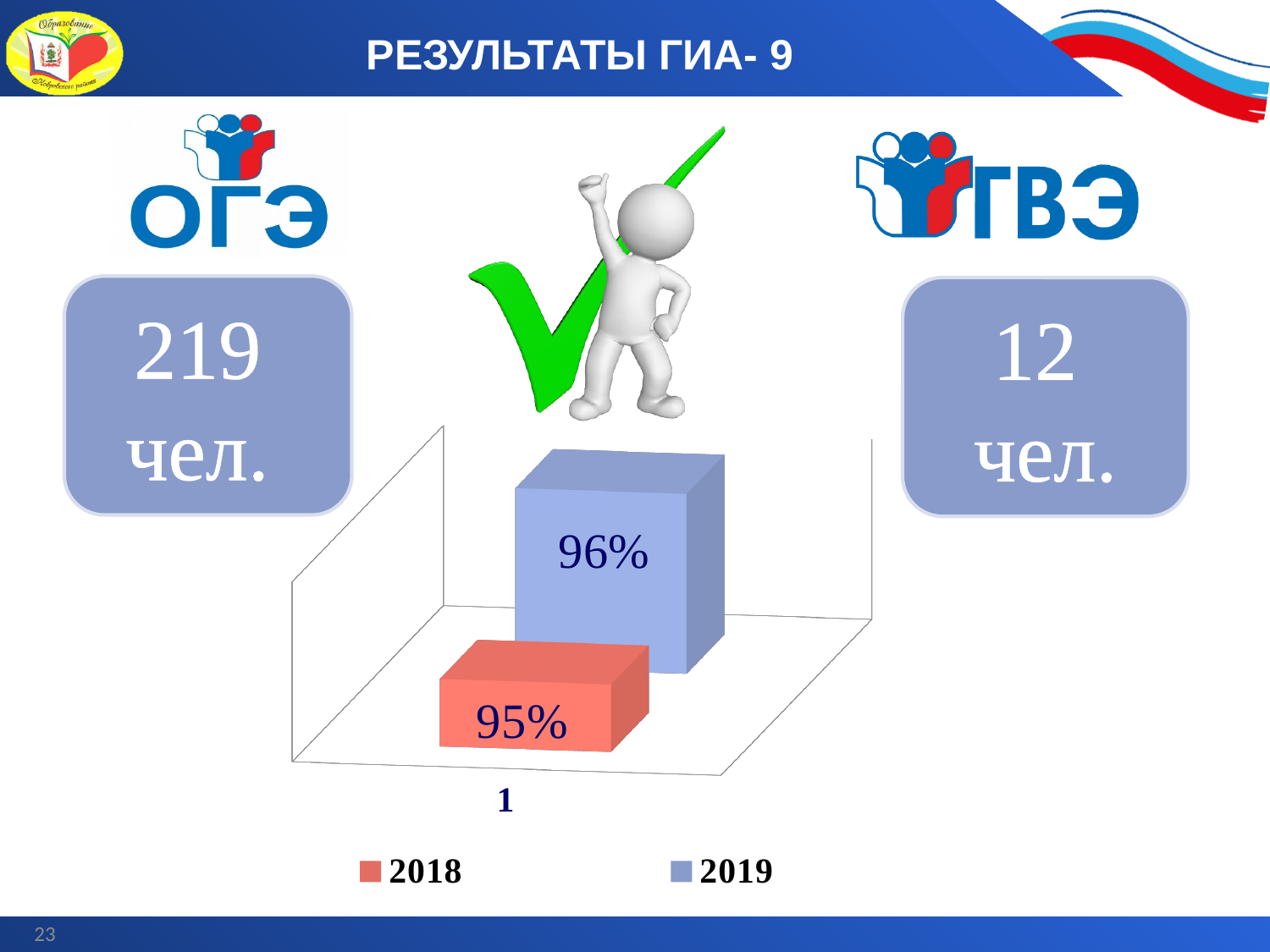
How many series does the legend list? 2 What is the difference between the 2019 value and the 2018 value? 1% Which series has the higher value, 2018 or 2019? 2019 What is the category label shown under the bars? 1 Which series has the lowest value in the chart? 2018 Which series has the highest value in the chart? 2019 Which colour represents the 2018 series in the legend? red How many categories are shown on the x axis of the chart? 1 Did the value rise or fall from 2018 to 2019? rise What kind of chart is shown on the slide? bar chart What is the value for 2019 in the chart? 96% What is the value for 2018 in the chart? 95%